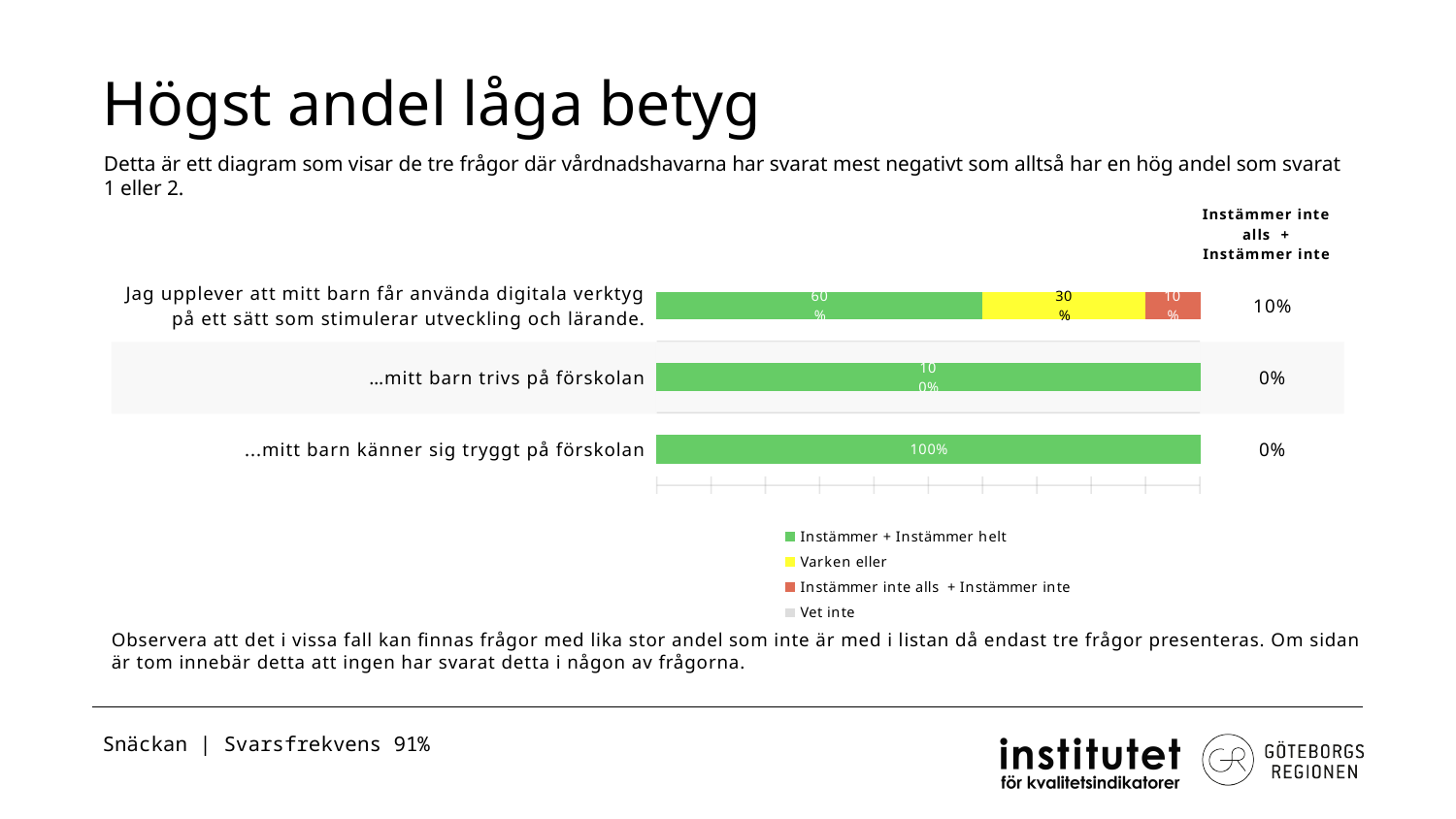
What kind of chart is shown on the slide? stacked bar chart How many questions (categories) are plotted in the chart? 3 What is the share of 'Instämmer + Instämmer helt' for '...mitt barn känner sig tryggt på förskolan'? 100% What colour represents 'Varken eller' in the legend? yellow What value is shown in the 'Instämmer inte alls + Instämmer inte' column for '…mitt barn trivs på förskolan'? 0% What is the share of 'Instämmer inte alls + Instämmer inte' for 'Jag upplever att mitt barn får använda digitala verktyg på ett sätt som stimulerar utveckling och lärande'? 10% How many series does the legend list? 4 What is the difference between the 'Instämmer + Instämmer helt' share and the 'Varken eller' share for the digital tools question? 30% Which question has the highest share of 'Instämmer inte alls + Instämmer inte'? Jag upplever att mitt barn får använda digitala verktyg på ett sätt som stimulerar utveckling och lärande What is the share of 'Varken eller' for 'Jag upplever att mitt barn får använda digitala verktyg på ett sätt som stimulerar utveckling och lärande'? 30% What is the share of 'Instämmer + Instämmer helt' for 'Jag upplever att mitt barn får använda digitala verktyg på ett sätt som stimulerar utveckling och lärande'? 60% Which is larger for the digital tools question: the 'Varken eller' share or the 'Instämmer inte alls + Instämmer inte' share? Varken eller